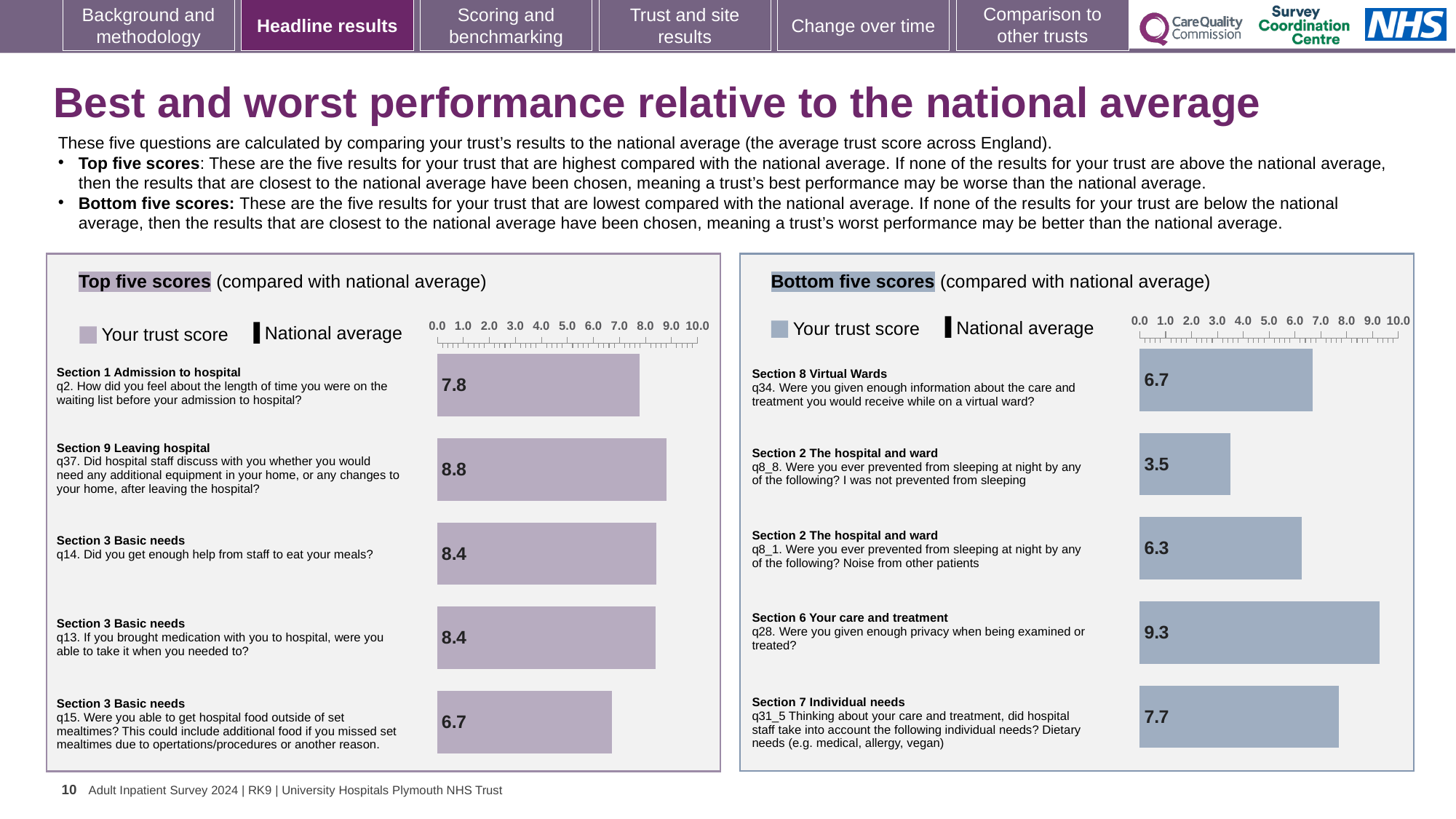
How many bars are shown in the Top five scores chart? 5 In the Top five scores chart, what is the difference between the scores for q37 and q15? 2.1 In the Top five scores chart, what is the trust score for q37 (Did hospital staff discuss with you whether you would need any additional equipment in your home)? 8.8 In the Top five scores chart, is the score for q2 greater or less than 7.0? greater In the Bottom five scores chart, what is the difference between the scores for q28 and q8_8? 5.8 In the Bottom five scores chart, which question has the lowest trust score? q8_8 (Section 2 The hospital and ward) What type of chart is the Top five scores chart? Bar chart In the Top five scores chart, which question has the highest trust score? q37 (Section 9 Leaving hospital) In the Bottom five scores chart, which has the larger score: q28 or q31_5? q28 In the Bottom five scores chart, what is the trust score for q8_8 (I was not prevented from sleeping)? 3.5 In the Bottom five scores chart, what is the trust score for q28 (Were you given enough privacy when being examined or treated)? 9.3 How many series does the legend of the Bottom five scores chart list? 2